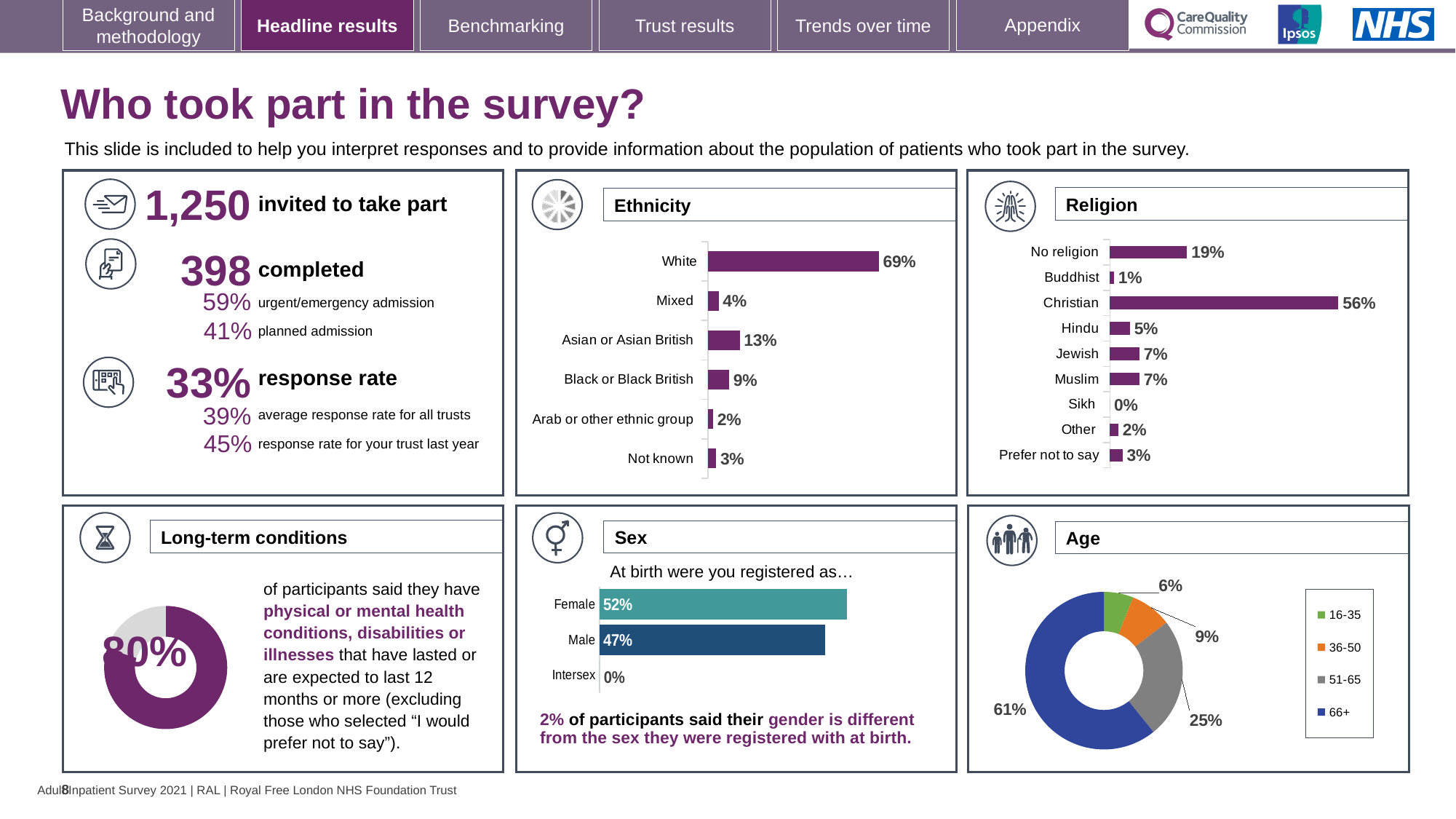
How many categories are shown in the Religion chart? 9 In the Religion chart, what percentage of participants were Christian? 56% In the Age chart, what share of participants were aged 66+? 61% How many age groups does the legend of the Age chart list? 4 How many ethnic group categories are shown in the Ethnicity chart? 6 In the Religion chart, which category has the highest percentage? Christian In the Ethnicity chart, what percentage of participants were White? 69% In the Ethnicity chart, which ethnic group has the lowest percentage? Arab or other ethnic group What type of chart is used for the Age breakdown? Doughnut chart In the Religion chart, which is larger: the percentage for No religion or the percentage for Hindu? No religion In the Sex chart, what percentage of participants were registered as Male at birth? 47% In the Ethnicity chart, what is the difference between the percentages for Asian or Asian British and Black or Black British? 4%